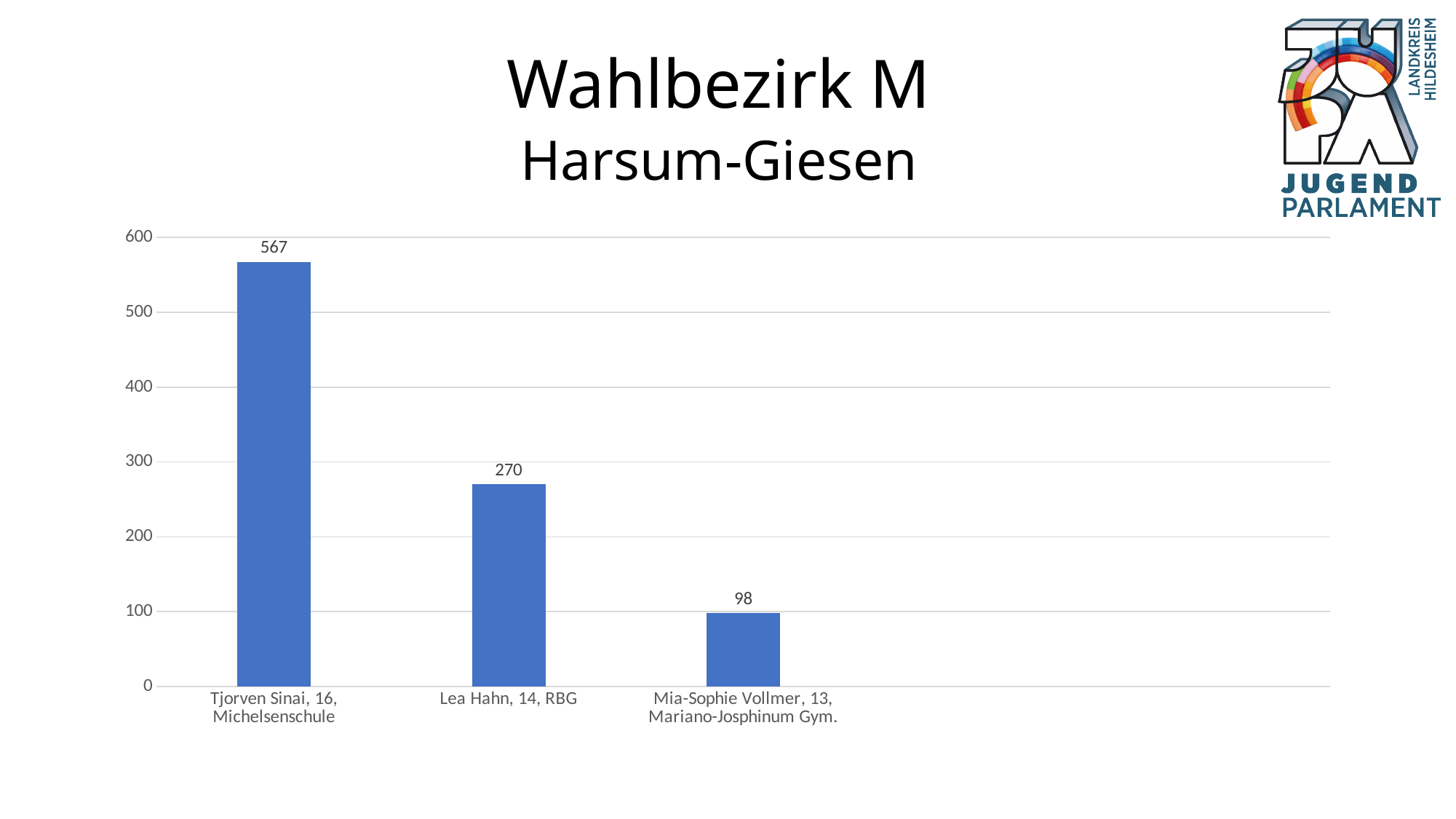
What value is shown for Lea Hahn, 14, RBG? 270 What value is shown for Mia-Sophie Vollmer, 13, Mariano-Josphinum Gym.? 98 Which candidate has the lowest value? Mia-Sophie Vollmer, 13, Mariano-Josphinum Gym. What kind of chart is shown on the slide? bar chart How many candidates are shown in the chart? 3 What is the difference between the values for Tjorven Sinai and Lea Hahn? 297 What is the title of the slide? Wahlbezirk M Harsum-Giesen What is the difference between the values for Lea Hahn and Mia-Sophie Vollmer? 172 Which candidate has the highest value? Tjorven Sinai, 16, Michelsenschule Is the value for Lea Hahn, 14, RBG greater or less than 300? less Which is larger, the value for Lea Hahn or the value for Mia-Sophie Vollmer? Lea Hahn What value is shown for Tjorven Sinai, 16, Michelsenschule? 567